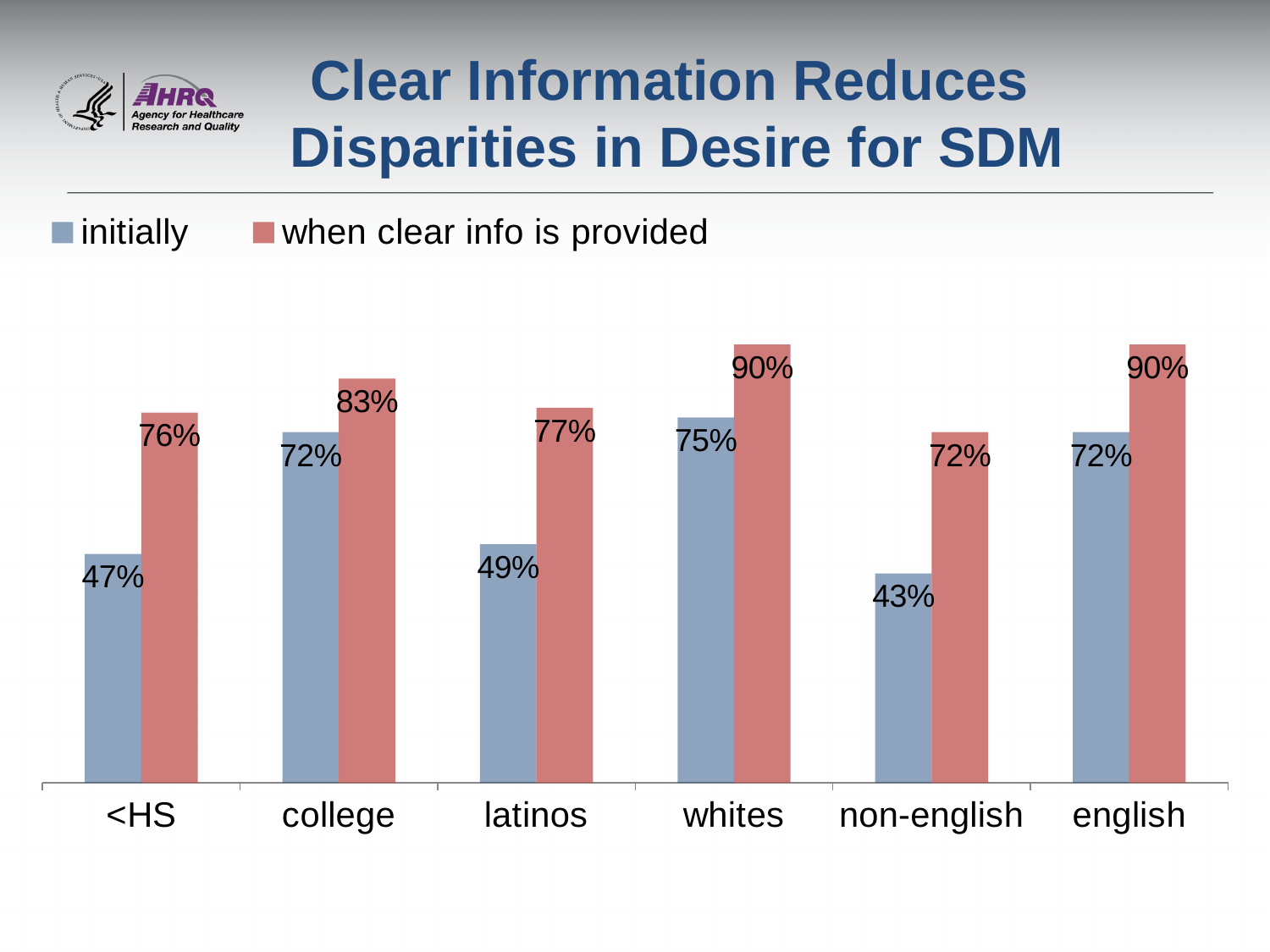
What is the 'initially' value for non-english? 43% Which category has the lowest 'initially' value? non-english Which is larger, the 'initially' value for college or the 'initially' value for <HS? college What kind of chart is shown on the slide? bar chart What is the difference between the 'when clear info is provided' and 'initially' values for non-english? 29% What is the difference between the 'initially' values for whites and latinos? 26% What is the 'initially' value for <HS? 47% What is the 'when clear info is provided' value for college? 83% Which category has the lowest 'when clear info is provided' value? non-english How many categories are shown on the x axis? 6 How many series does the legend list? 2 What is the 'when clear info is provided' value for latinos? 77%